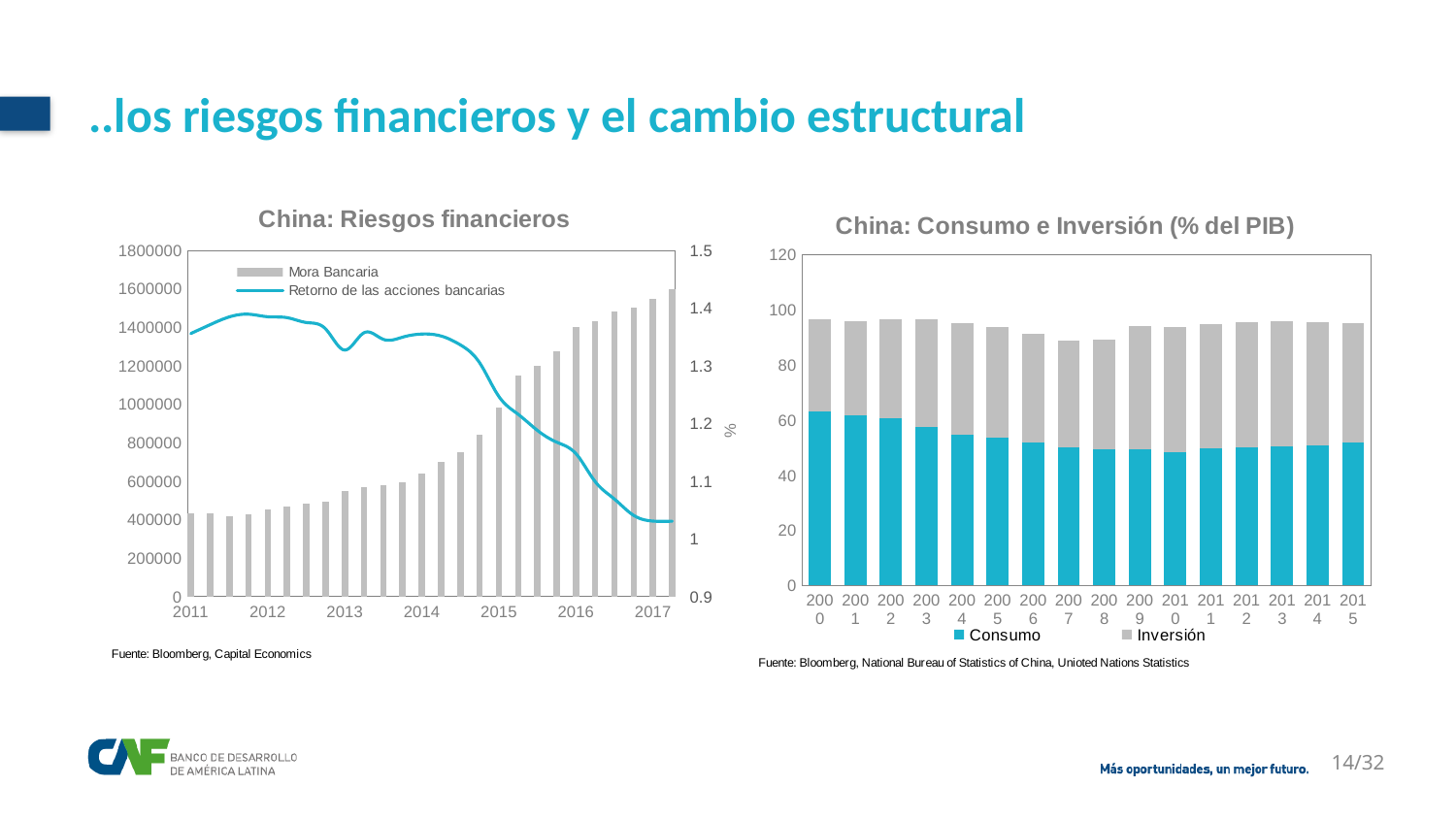
In 'China: Consumo e Inversión (% del PIB)', is the Inversión value larger in 2000 or in 2010? 2010 In 'China: Consumo e Inversión (% del PIB)', which year has the highest Consumo value? 2000 In 'China: Consumo e Inversión (% del PIB)', is the Consumo value for 2010 greater or less than 60? less In 'China: Consumo e Inversión (% del PIB)', is the Consumo value for 2000 greater or less than 60? greater In 'China: Riesgos financieros', do the Mora Bancaria bars rise or fall from 2011 to 2017? Rise In the chart 'China: Consumo e Inversión (% del PIB)', how many years are shown on the x axis? 16 In 'China: Riesgos financieros', is the Retorno de las acciones bancarias value in 2017 greater or less than 1.1? less How many series does the legend of 'China: Consumo e Inversión (% del PIB)' list? 2 What type of chart is 'China: Consumo e Inversión (% del PIB)'? Stacked bar chart In 'China: Consumo e Inversión (% del PIB)', which colour represents Consumo? Blue How many series does the legend of 'China: Riesgos financieros' list? 2